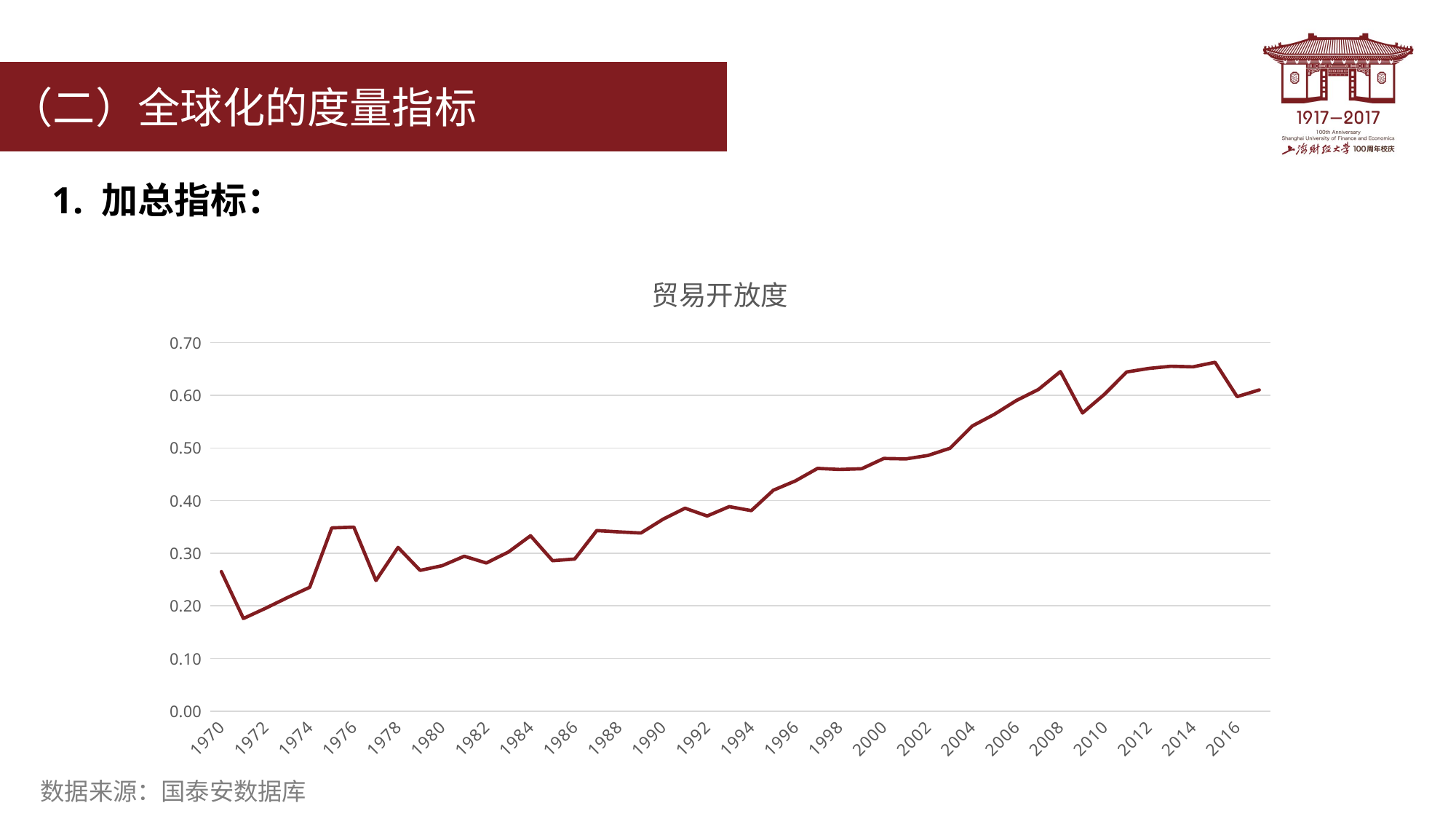
Which year has the larger value, 1976 or 1978? 1976 Is the value for 2000 greater or less than 0.50? less What is the title of the chart? 贸易开放度 What kind of chart is shown on the slide? line chart How many year labels are shown on the x axis? 24 Is the value for 1970 greater or less than 0.30? less Is the value for 1998 greater or less than 0.40? greater Which year has the larger value, 1990 or 2000? 2000 Overall, does the value rise or fall from 1970 to 2016? rise